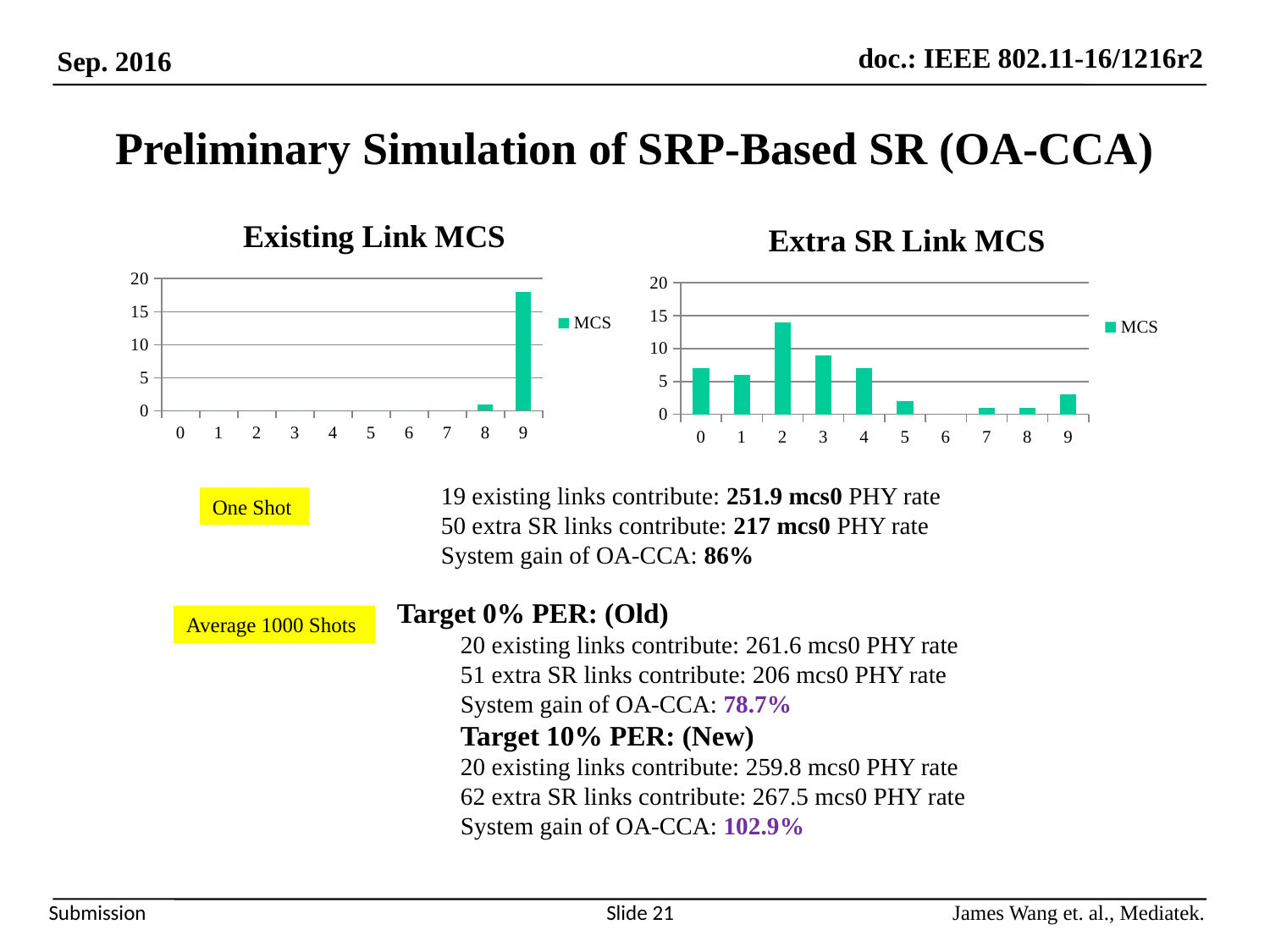
In the Extra SR Link MCS chart, is the value for category 3 greater or less than 10? less What kind of chart is the Existing Link MCS chart? bar chart In the Extra SR Link MCS chart, which category has the highest value? 2 In the Extra SR Link MCS chart, which is larger, the value for category 0 or the value for category 5? 0 In the Extra SR Link MCS chart, which is larger, the value for category 2 or the value for category 3? 2 In the Existing Link MCS chart, which category has the highest value? 9 What is the legend entry shown on the Existing Link MCS chart? MCS In the Extra SR Link MCS chart, is the value for category 5 greater or less than 5? less In the Extra SR Link MCS chart, is the value for category 2 greater or less than 10? greater How many series does the legend of the Extra SR Link MCS chart list? 1 How many categories are shown on the x axis of the Extra SR Link MCS chart? 10